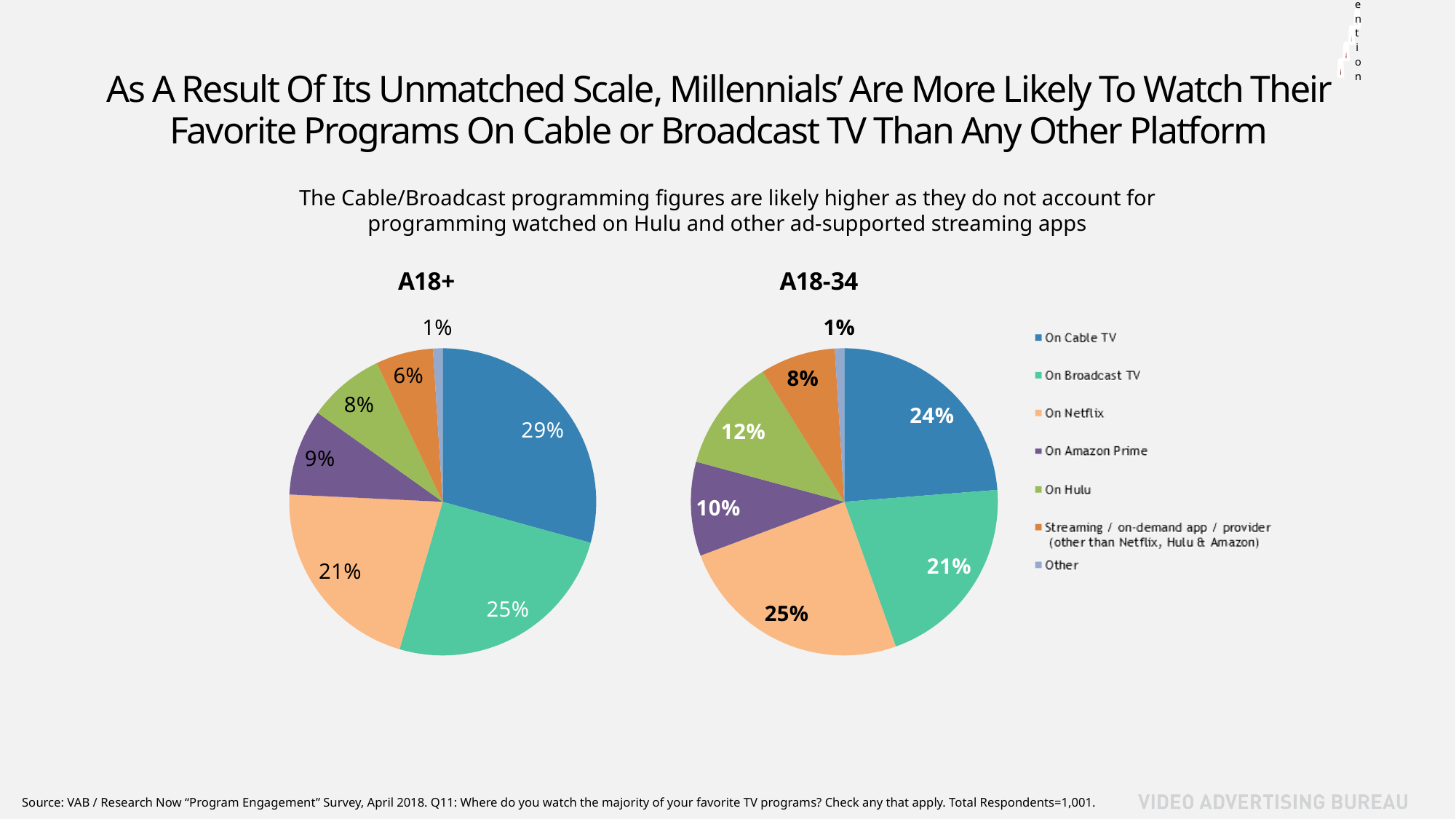
In the A18+ pie chart, which category has the largest share? On Cable TV In the A18+ pie chart, what share is On Amazon Prime? 9% In the A18-34 pie chart, which category has the smallest share? Other In the A18-34 pie chart, what share is On Netflix? 25% In the A18+ pie chart, what share is On Cable TV? 29% In the A18-34 pie chart, what share is On Hulu? 12% Which colour represents On Broadcast TV in the pie charts? Green In the A18+ pie chart, what is the difference between the On Cable TV share and the On Netflix share? 8% In the A18-34 pie chart, which is larger: On Hulu or On Amazon Prime? On Hulu What type of chart is used for the A18+ and A18-34 data? Pie chart How many categories does the legend list for the pie charts? 7 In the A18-34 pie chart, which category has the largest share? On Netflix